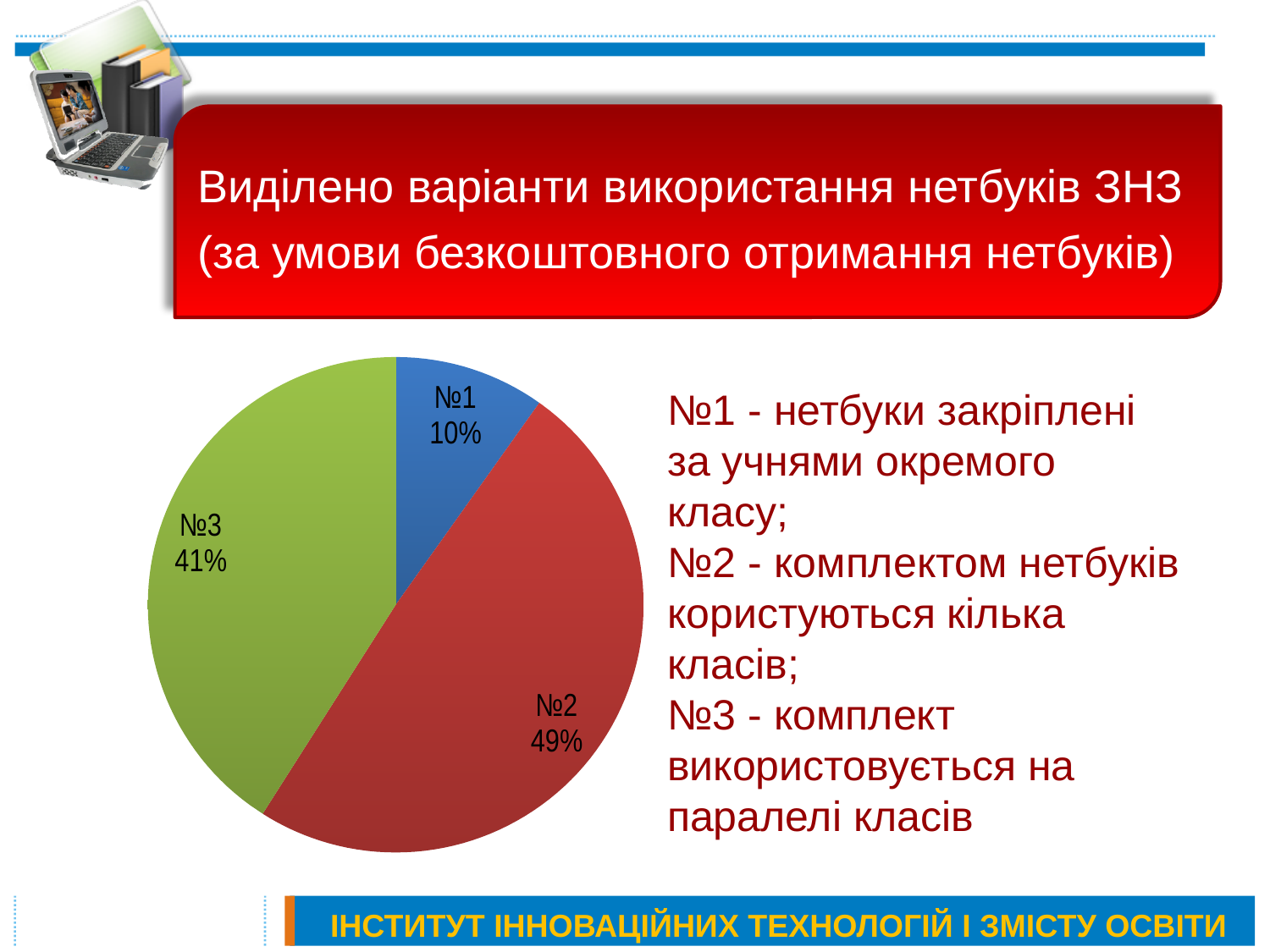
What kind of chart is shown on the slide? pie chart What share of the pie does slice №1 have? 10% Which slice is the smallest in the pie chart? №1 Which is larger, slice №3 or slice №1? №3 What is the difference in percentage points between slice №2 and slice №3? 8 What colour is slice №3 in the pie chart? green Which slice is the largest in the pie chart? №2 How many slices does the pie chart have? 3 What is the difference in percentage points between slice №3 and slice №1? 31 What share of the pie does slice №2 have? 49% What colour is slice №2 in the pie chart? red What share of the pie does slice №3 have? 41%